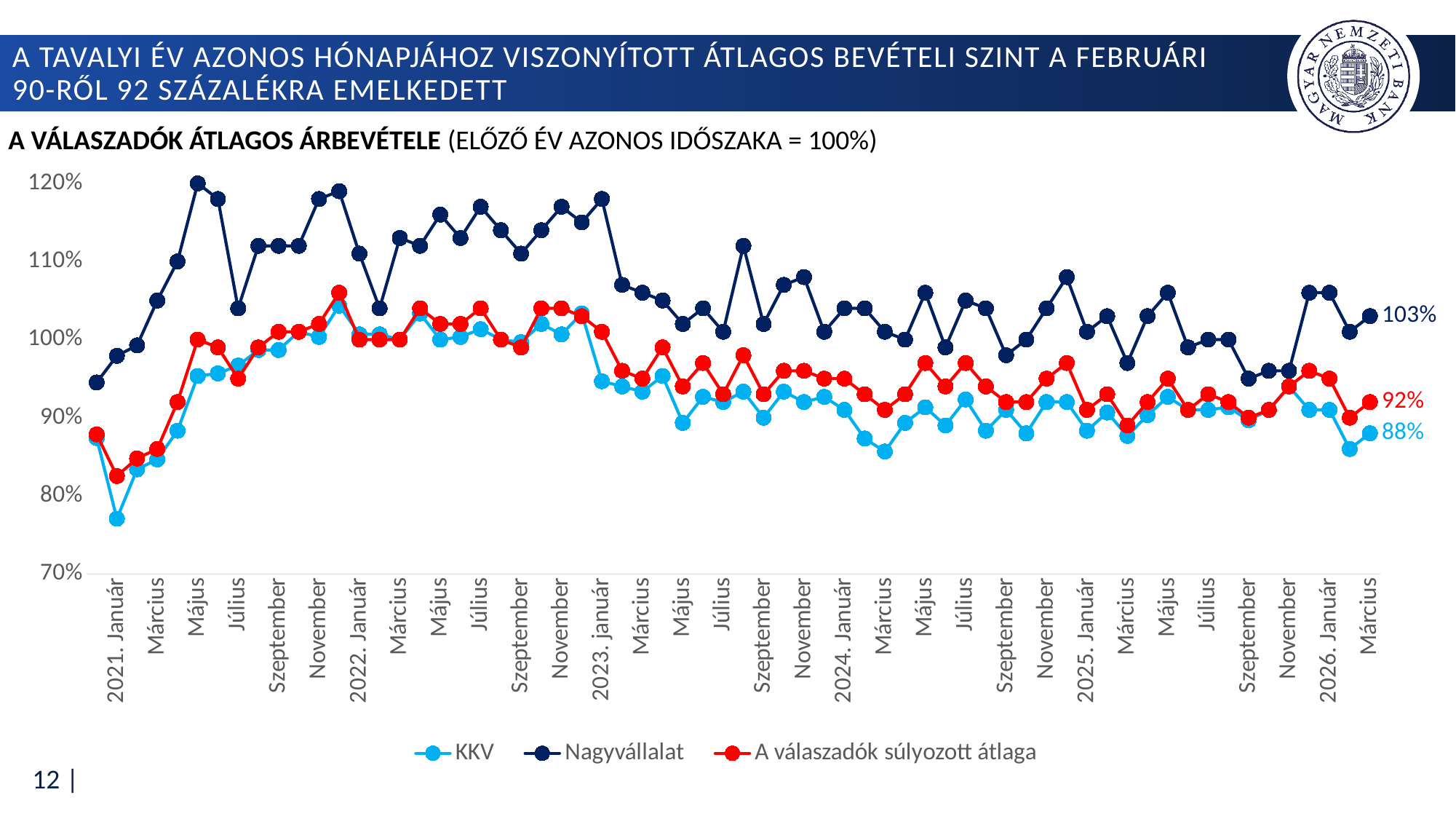
What is the value for KKV at the last point (2026 Március)? 88% What is the difference between the Nagyvállalat and KKV values at the last point (2026 Március)? 15 percentage points What is the value for Nagyvállalat at the last point (2026 Március)? 103% How many series does the legend list? 3 What is the title of the chart? A VÁLASZADÓK ÁTLAGOS ÁRBEVÉTELE (ELŐZŐ ÉV AZONOS IDŐSZAKA = 100%) Which series has the highest value at the last point (2026 Március)? Nagyvállalat Is the value for Nagyvállalat in Május 2021 greater or less than 110%? greater What is the value for A válaszadók súlyozott átlaga at the last point (2026 Március)? 92% Is the value for KKV in 2021. Január greater or less than 80%? less Which series has the lowest value at the last point (2026 Március)? KKV What is the difference between A válaszadók súlyozott átlaga and KKV at the last point (2026 Március)? 4 percentage points What kind of chart is shown on the slide? line chart